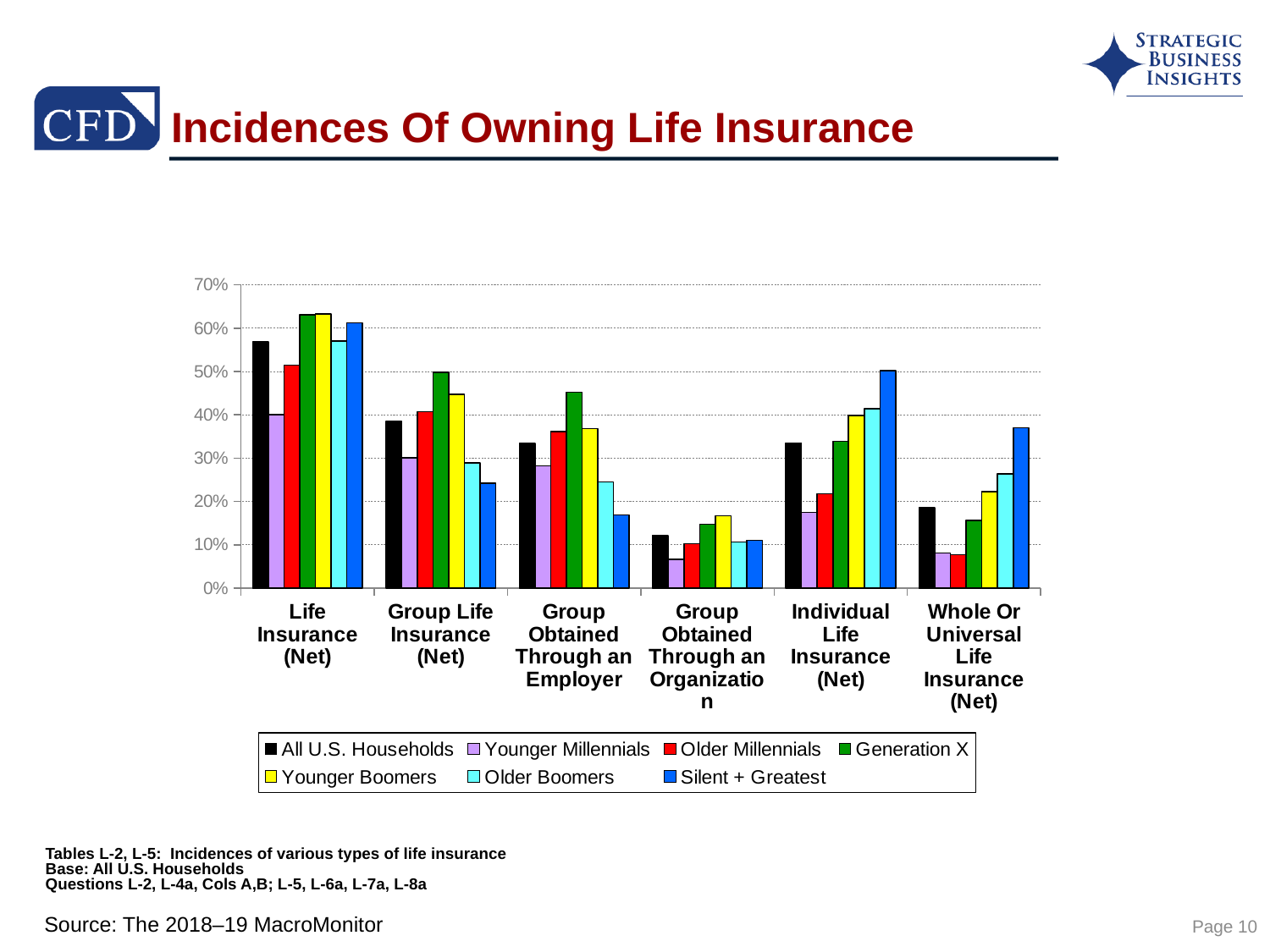
Which series has the highest value for Individual Life Insurance (Net)? Silent + Greatest Is the value for Silent + Greatest in Individual Life Insurance (Net) greater or less than 40%? greater Which series has the highest value for Group Life Insurance (Net)? Generation X What is the title of the slide's chart? Incidences Of Owning Life Insurance How many series does the legend list? 7 Which series has the lowest value for Group Obtained Through an Organization? Younger Millennials What kind of chart is shown on the slide? bar chart Is the value for All U.S. Households in Life Insurance (Net) greater or less than 50%? greater For Whole Or Universal Life Insurance (Net), which is larger: Silent + Greatest or Younger Millennials? Silent + Greatest Is the value for Younger Millennials in Life Insurance (Net) greater or less than 50%? less How many insurance categories are shown along the x axis? 6